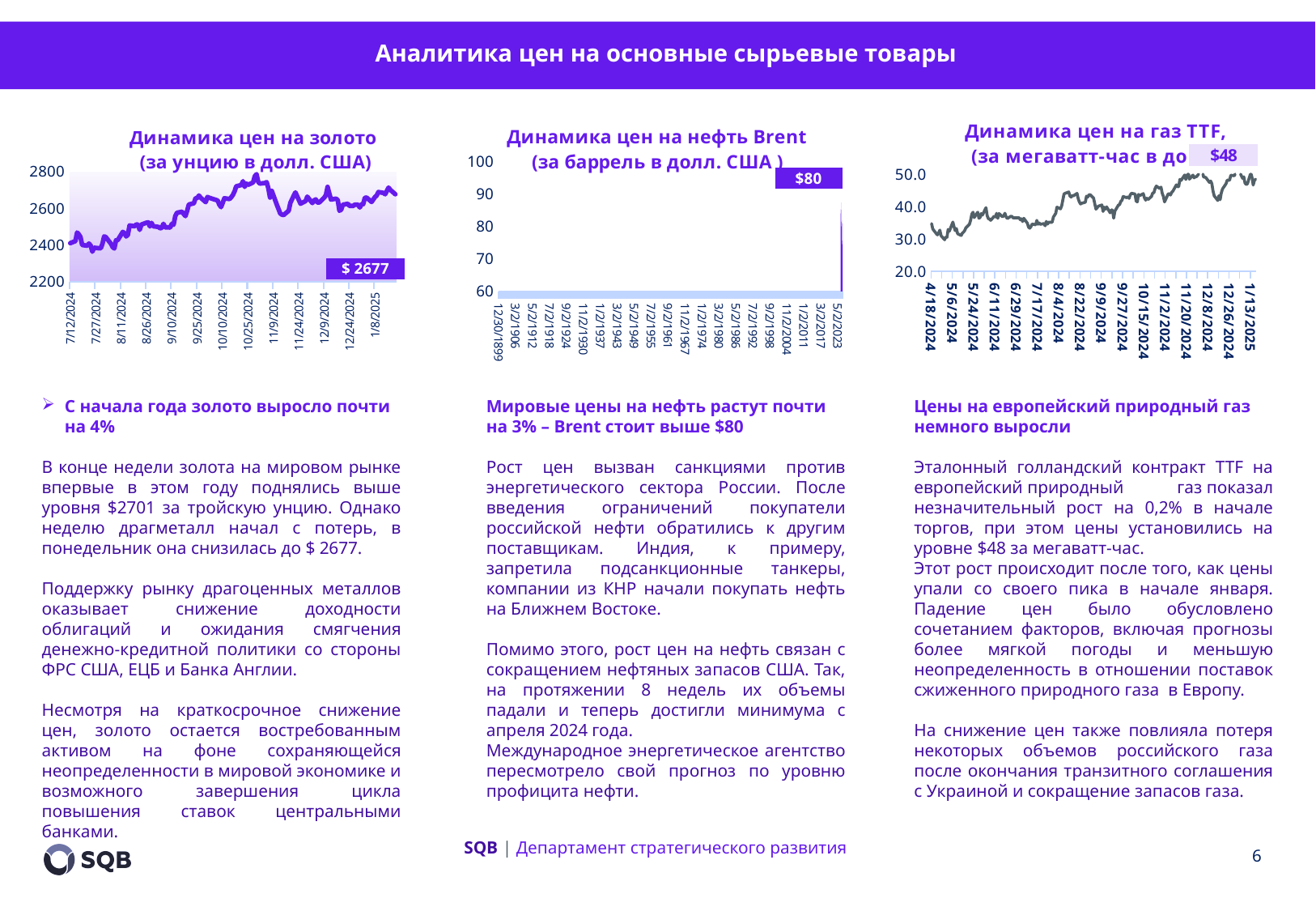
On the gold price chart (Динамика цен на золото), is the value around 10/25/2024 greater or less than 2600? greater On the TTF gas price chart (Динамика цен на газ TTF), what value is shown in the data label? $48 On the gold price chart (Динамика цен на золото), what is the latest value shown in the data label? $ 2677 On the gold price chart (Динамика цен на золото), is the value at 7/12/2024 greater or less than 2600? less On the TTF gas price chart (Динамика цен на газ TTF), is the value at 4/18/2024 greater or less than 40.0? less On the gold price chart (Динамика цен на золото), do the values generally rise or fall from 7/12/2024 to 1/8/2025? rise How many charts are shown on the slide? 3 On the Brent oil price chart (Динамика цен на нефть Brent), what is the highest value shown on the vertical axis? 100 On the TTF gas price chart (Динамика цен на газ TTF), do the values generally rise or fall from 4/18/2024 to 1/13/2025? rise What kind of chart is the gold price chart (Динамика цен на золото)? line chart On the Brent oil price chart (Динамика цен на нефть Brent), what value is shown in the data label? $80